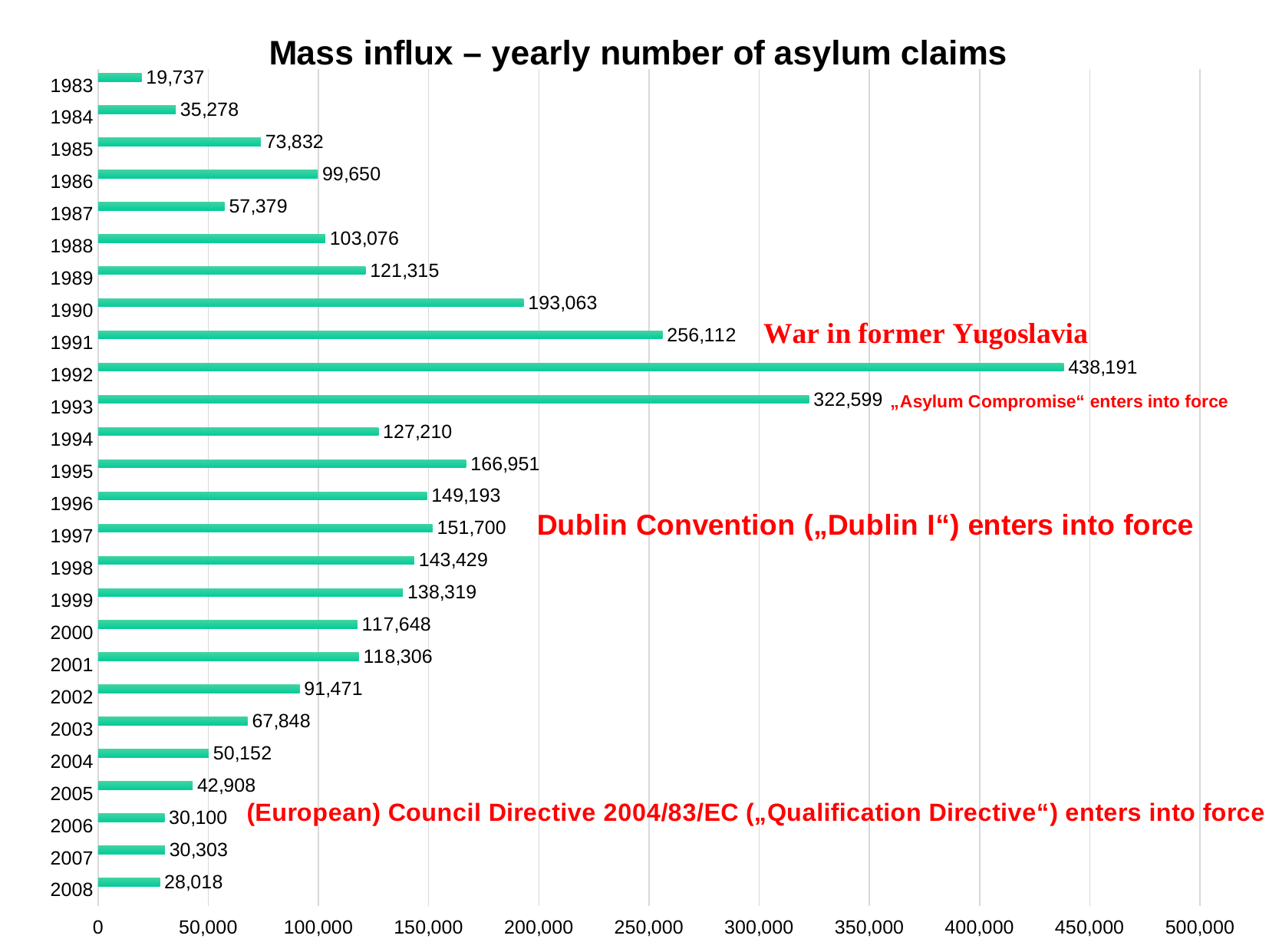
What kind of chart is shown on the slide? Bar chart Which year has the highest number of asylum claims? 1992 How many years are shown in the chart? 26 Which year has the lowest number of asylum claims? 1983 What is the number of asylum claims shown for 1992? 438,191 Which year had more asylum claims, 1995 or 1999? 1995 What is the difference between the asylum claims in 1993 and in 1994? 195,389 What is the difference between the asylum claims in 1992 and in 1991? 182,079 What is the number of asylum claims shown for 1997? 151,700 What is the number of asylum claims shown for 2008? 28,018 What is the title of the chart? Mass influx – yearly number of asylum claims Which year had more asylum claims, 1986 or 1988? 1988